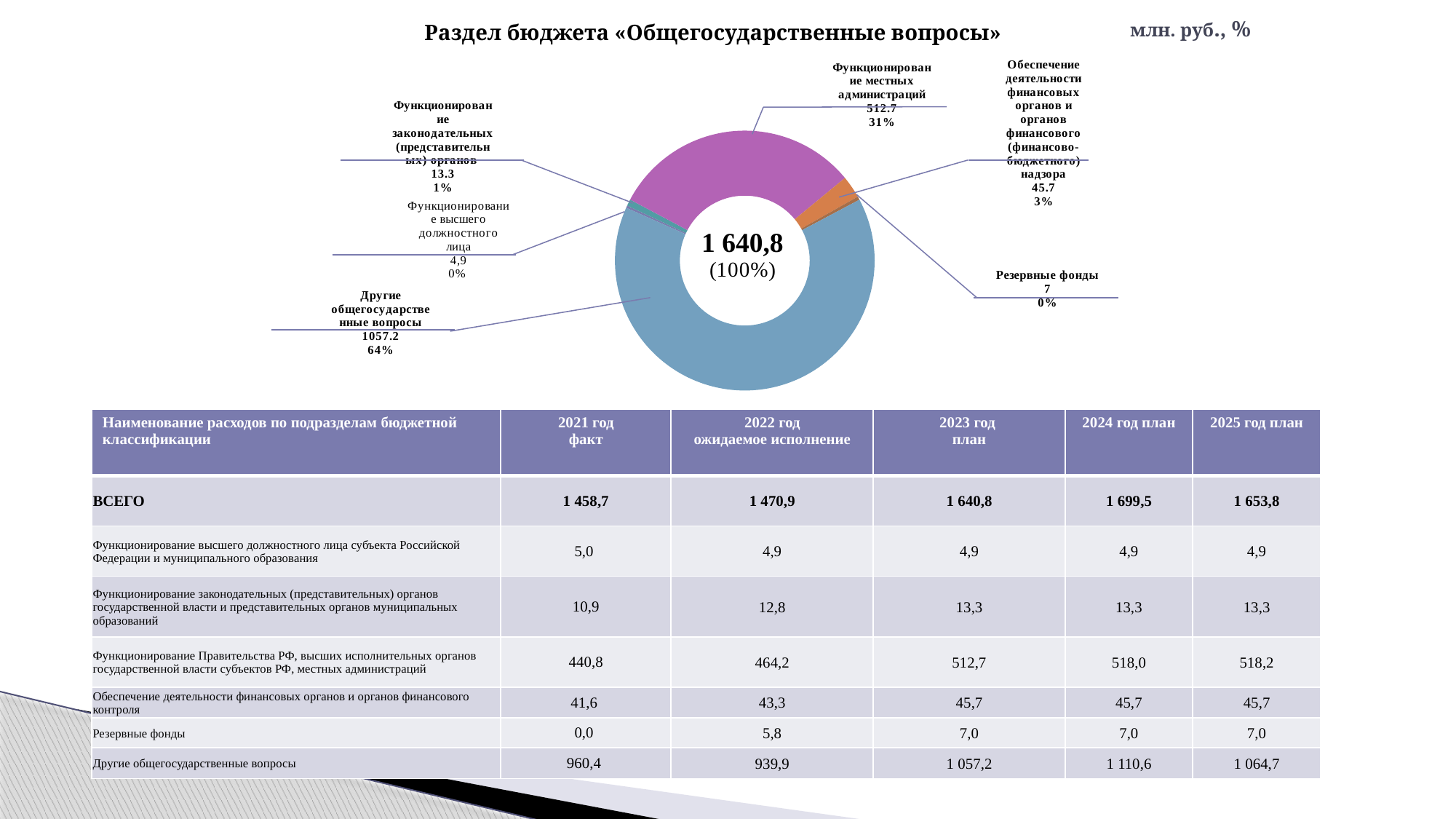
Which is larger in the chart: «Функционирование местных администраций» or «Обеспечение деятельности финансовых органов и органов финансового (финансово-бюджетного) надзора»? Функционирование местных администраций What is the value shown for «Резервные фонды» in the chart? 7 What is the total value shown in the centre of the donut chart? 1 640,8 What is the value shown for «Обеспечение деятельности финансовых органов и органов финансового (финансово-бюджетного) надзора» in the chart? 45.7 What share of the chart does «Функционирование местных администраций» represent? 31% What is the value shown for «Другие общегосударственные вопросы» in the chart? 1057.2 What is the difference between the values for «Функционирование местных администраций» (512.7) and «Обеспечение деятельности финансовых органов и органов финансового (финансово-бюджетного) надзора» (45.7) in the chart? 467.0 What kind of chart is shown on the slide? Pie (donut) chart What is the title of the chart on the slide? Раздел бюджета «Общегосударственные вопросы» What share of the chart does «Другие общегосударственные вопросы» represent? 64% How many slices (categories) does the donut chart have? 6 Which category has the largest slice in the chart? Другие общегосударственные вопросы